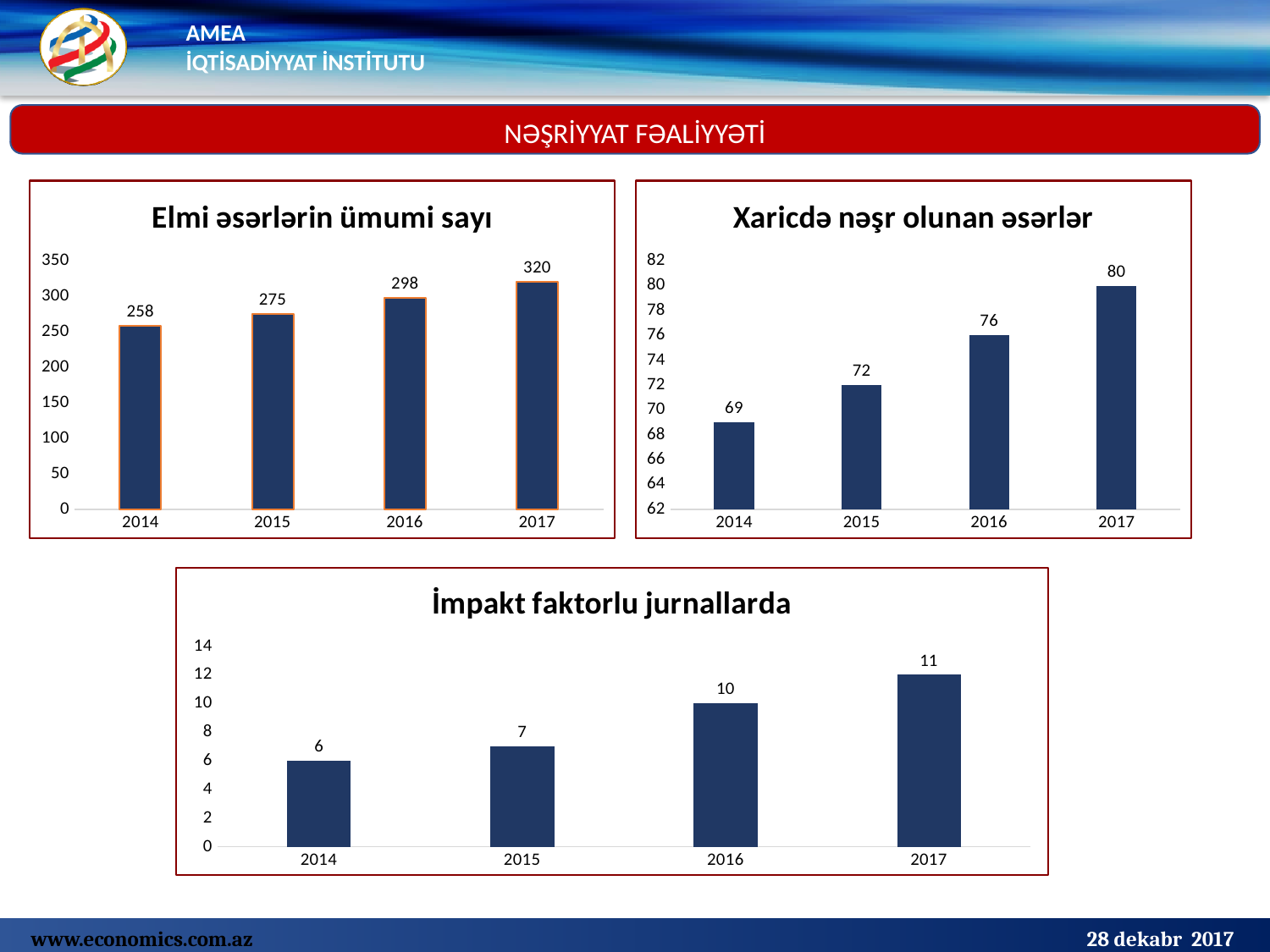
In the chart titled "Xaricdə nəşr olunan əsərlər", what is the value for 2015? 72 In the chart titled "Elmi əsərlərin ümumi sayı", what is the value for 2016? 298 In the chart titled "İmpakt faktorlu jurnallarda", which is larger, the value for 2015 or the value for 2017? 2017 How many charts are shown on the slide? 3 In the chart titled "Elmi əsərlərin ümumi sayı", what is the difference between the values for 2017 and 2014? 62 In the chart titled "Elmi əsərlərin ümumi sayı", do the values rise or fall from 2014 to 2017? rise In the chart titled "Xaricdə nəşr olunan əsərlər", what is the difference between the values for 2017 and 2016? 4 In the chart titled "Elmi əsərlərin ümumi sayı", which year has the highest value? 2017 In the chart titled "Xaricdə nəşr olunan əsərlər", how many years are shown on the x axis? 4 In the chart titled "İmpakt faktorlu jurnallarda", what is the value for 2016? 10 In the chart titled "Xaricdə nəşr olunan əsərlər", which year has the lowest value? 2014 In the chart titled "İmpakt faktorlu jurnallarda", what kind of chart is shown? bar chart